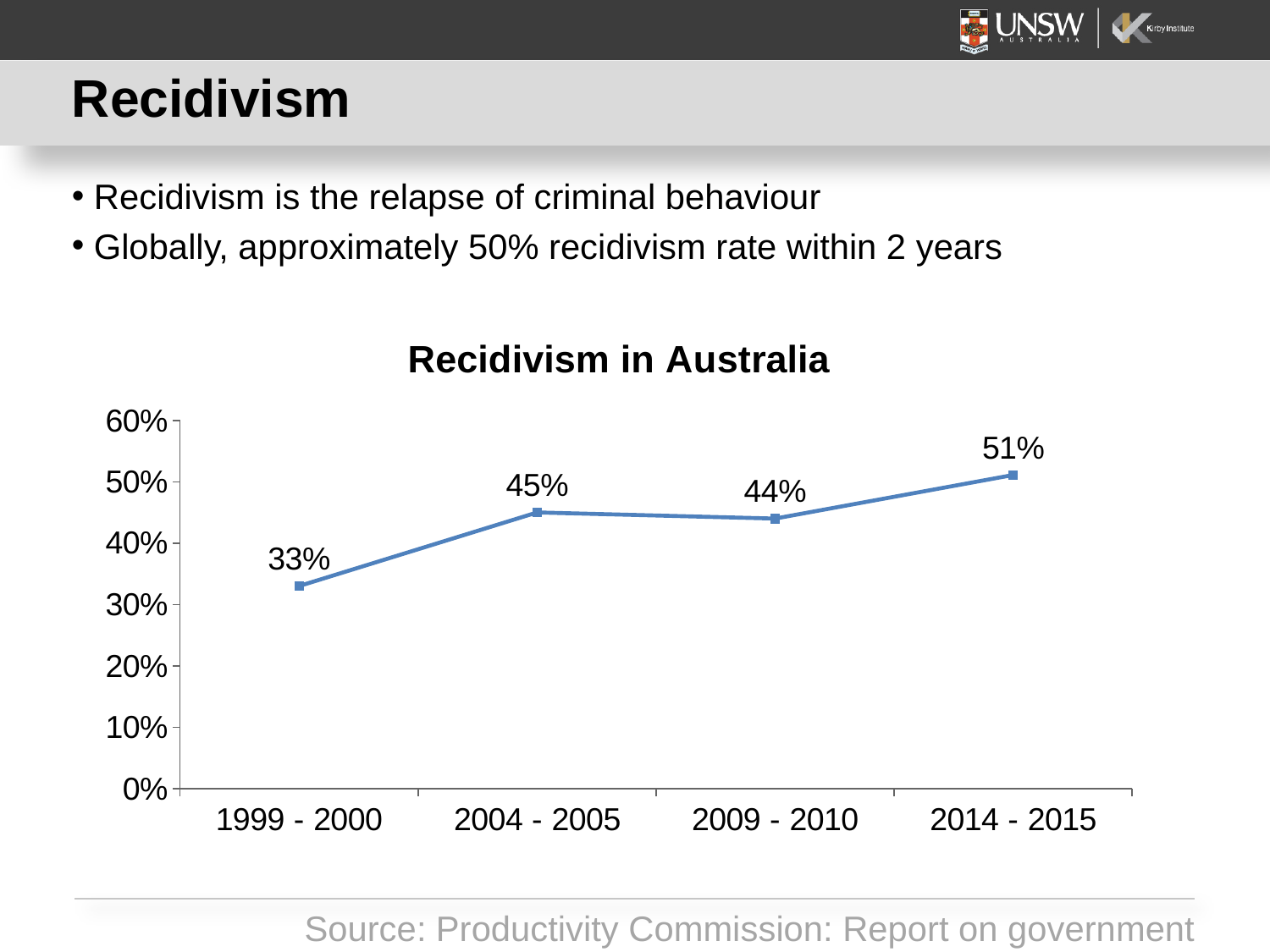
What kind of chart is used to show recidivism in Australia? line chart What is the recidivism rate shown for 1999 - 2000? 33% What is the title of the chart? Recidivism in Australia Which period has the lowest recidivism rate? 1999 - 2000 Which period has the highest recidivism rate? 2014 - 2015 What is the recidivism rate shown for 2014 - 2015? 51% Which period has a higher recidivism rate, 2004 - 2005 or 2009 - 2010? 2004 - 2005 What is the recidivism rate shown for 2004 - 2005? 45% What is the recidivism rate shown for 2009 - 2010? 44% What is the difference between the recidivism rate in 2014 - 2015 and in 1999 - 2000? 18% How many time periods are plotted on the chart? 4 Is the recidivism rate for 2014 - 2015 greater or less than 50%? greater